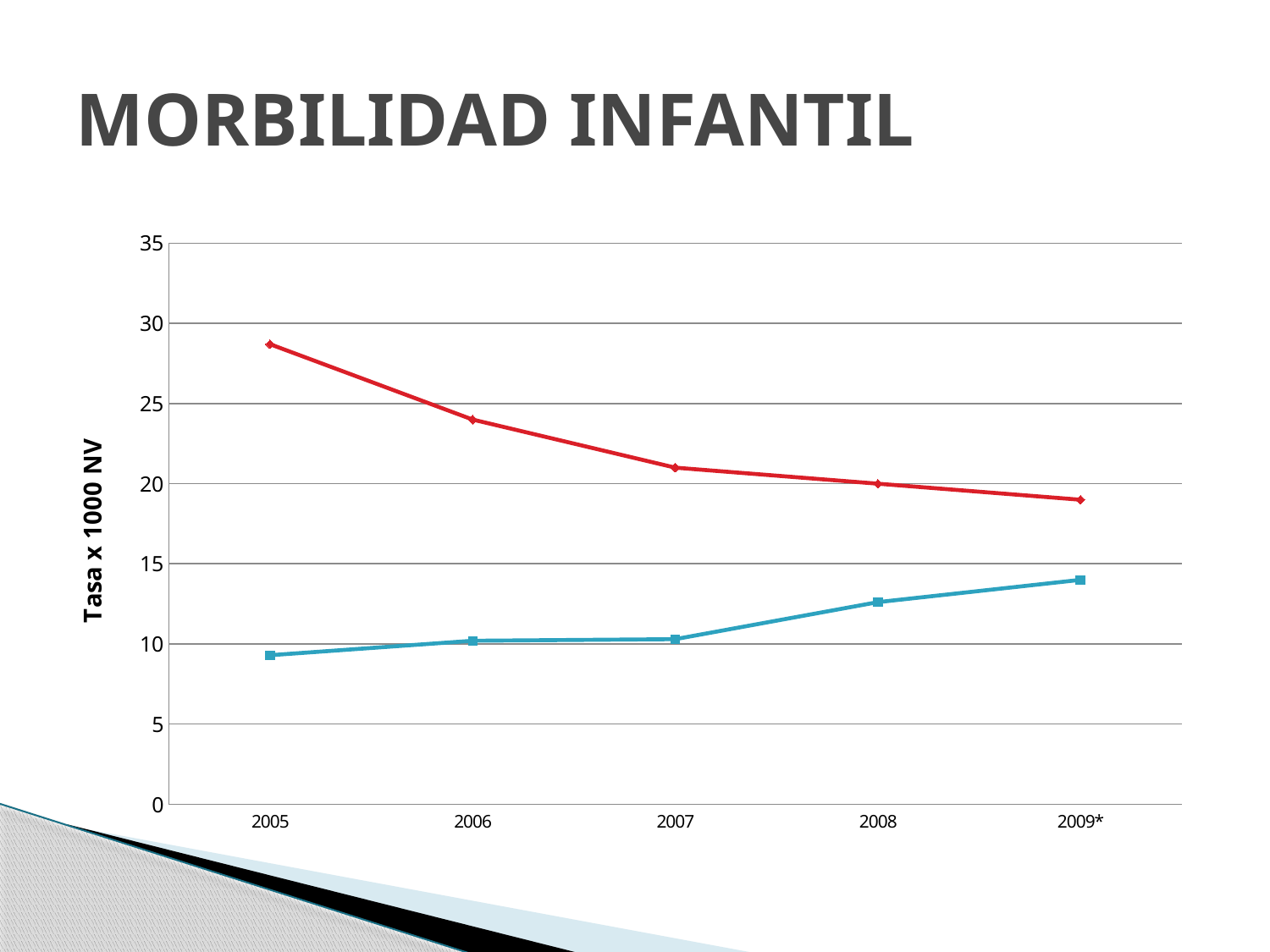
What is the title of the y axis? Tasa x 1000 NV How many years are shown on the x axis of the chart? 5 In which year is the red line at its highest value? 2005 In which year is the blue line at its lowest value? 2005 Does the blue line rise or fall from 2005 to 2009*? rise What is the title of the slide containing the chart? MORBILIDAD INFANTIL Is the value of the red line in 2005 greater or less than 25? greater Is the value of the blue line in 2005 greater or less than 10? less In 2009*, which line has the higher value, the red line or the blue line? the red line What kind of chart is shown on the slide? line chart Does the red line rise or fall from 2005 to 2009*? fall How many lines are plotted on the chart? 2